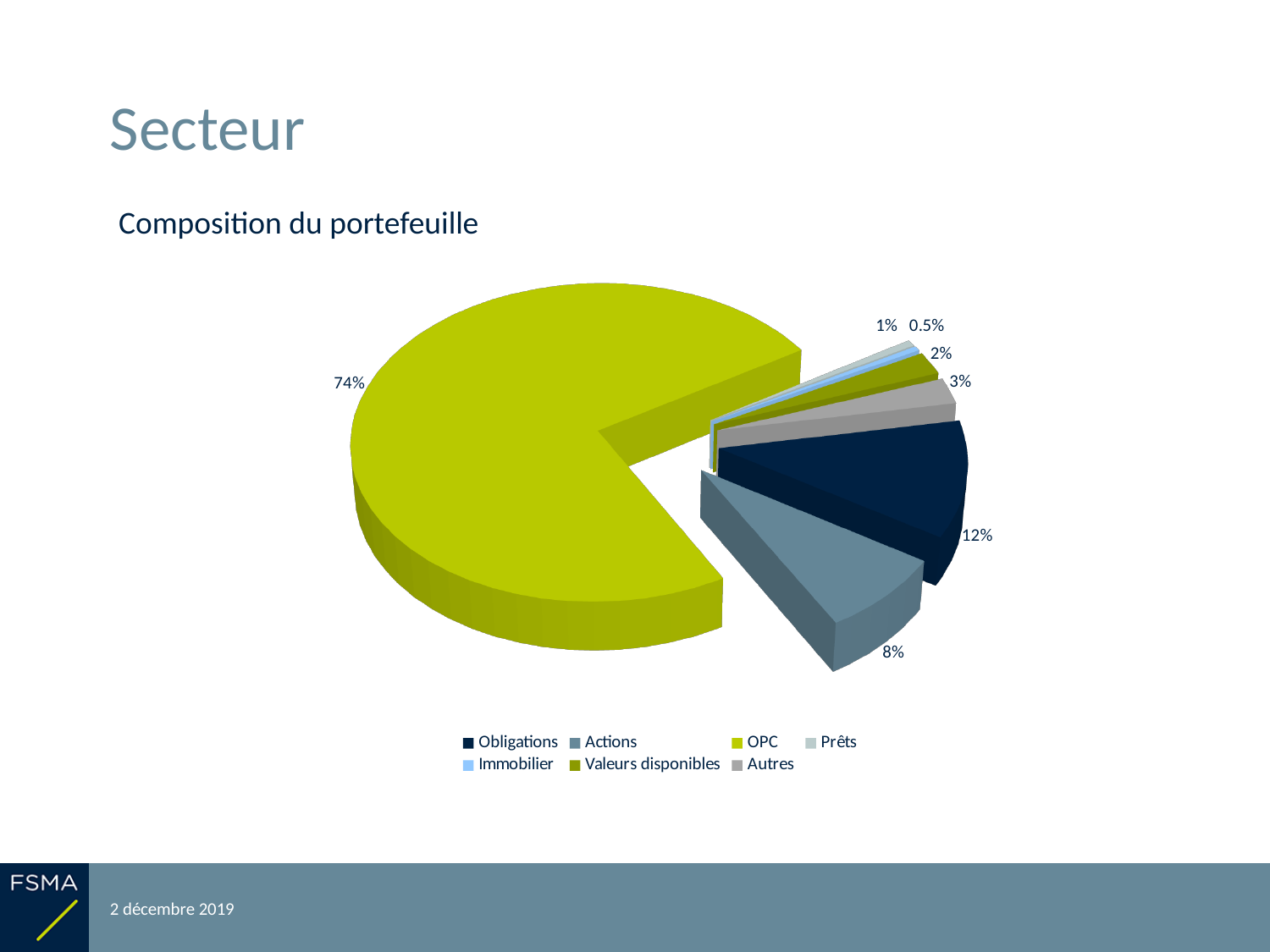
What share of the portfolio is Obligations? 12% What type of chart is shown on the slide? pie chart Which is larger, the share for Obligations or the share for Actions? Obligations Which category has the smallest slice of the pie? Immobilier How many categories does the legend list? 7 What share of the portfolio is Autres? 3% What is the difference between the Obligations share and the Actions share? 4% What share of the portfolio is OPC? 74% Which category has the largest slice of the pie? OPC What is the title of the chart? Composition du portefeuille